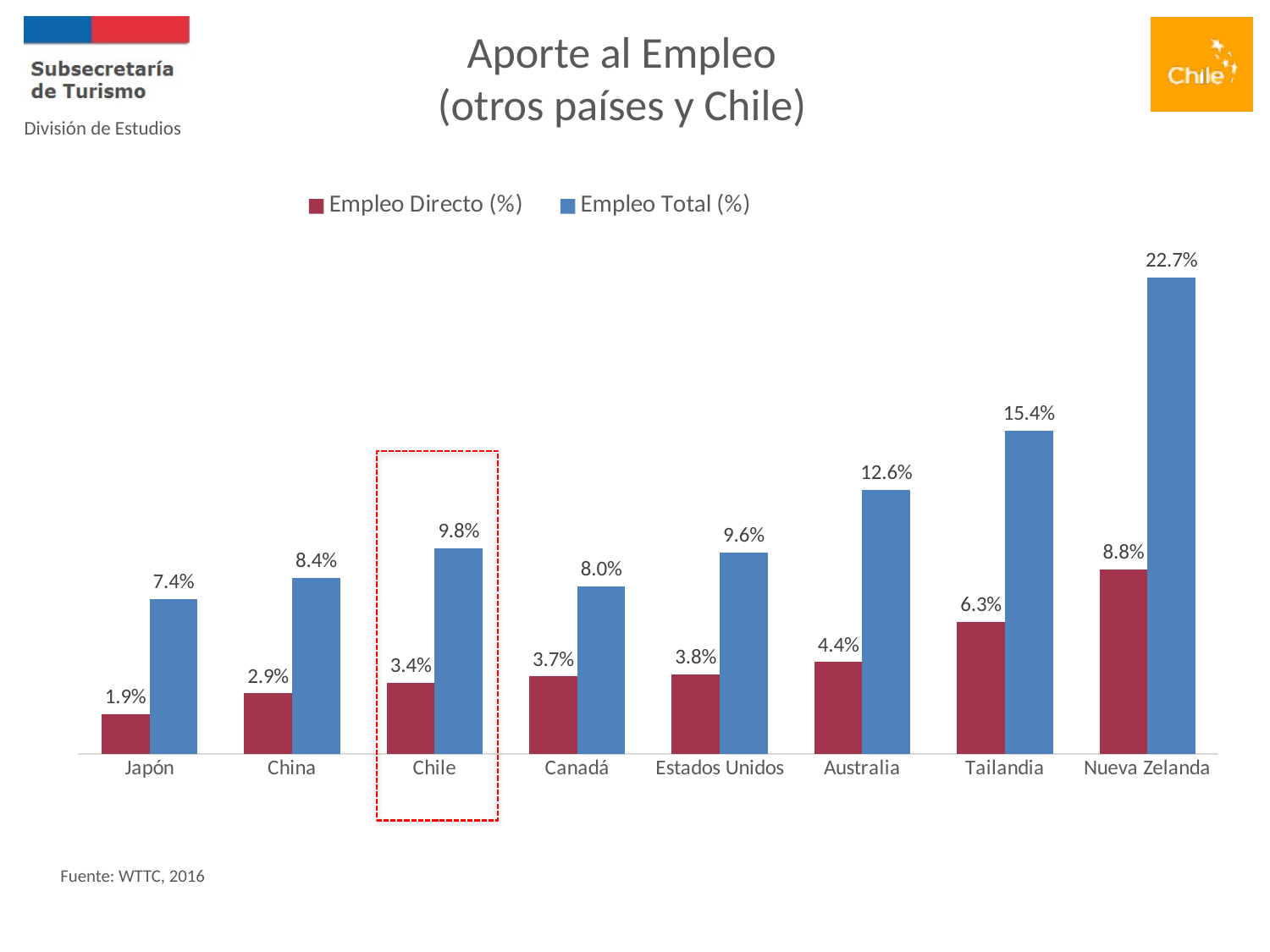
What is the difference between Empleo Total (%) and Empleo Directo (%) for Tailandia? 9.1% Which country is highlighted with a red dashed box? Chile Which country has the highest Empleo Total (%)? Nueva Zelanda Which is larger, the Empleo Total (%) for Canadá or for Estados Unidos? Estados Unidos What is the Empleo Total (%) value for Australia? 12.6% What kind of chart is shown on the slide? Bar chart Do the Empleo Total (%) values rise or fall from Canadá to Nueva Zelanda? Rise How many countries are shown on the x axis? 8 What is the Empleo Directo (%) value for Japón? 1.9% What is the Empleo Total (%) value for Chile? 9.8% How many series does the legend list? 2 Which country has the lowest Empleo Directo (%)? Japón